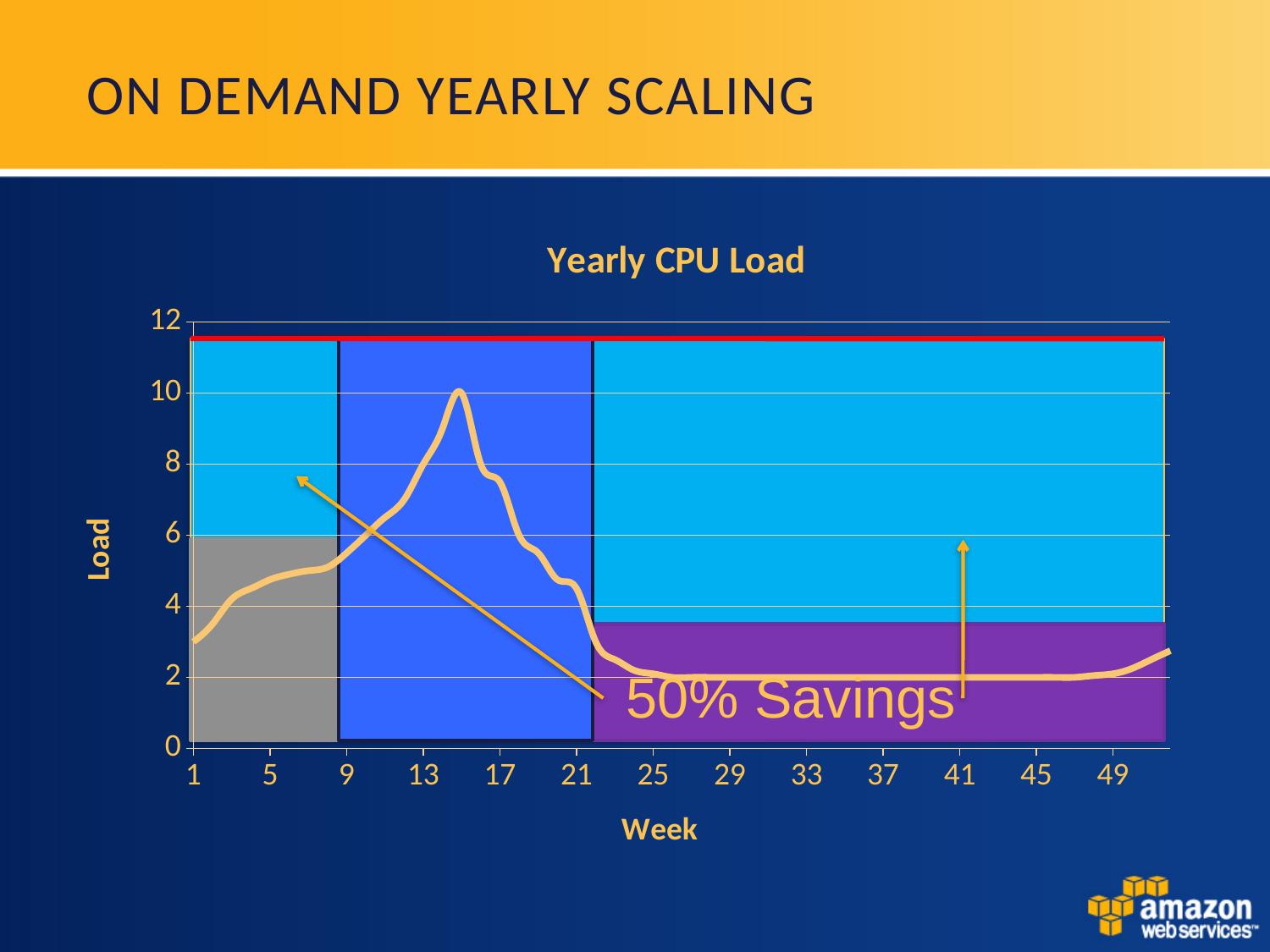
Is the CPU load at week 15 greater or less than 8? greater Is the CPU load at week 45 greater or less than 4? less What savings percentage is annotated on the chart? 50% Savings Is the CPU load at week 1 greater or less than 4? less Does the CPU load rise or fall between week 15 and week 25? fall Which is larger, the CPU load at week 15 or at week 33? week 15 What is the title of the chart? Yearly CPU Load What kind of chart is shown on the slide? line chart Does the CPU load rise or fall between week 9 and week 15? rise Between which two labelled weeks does the line reach its highest point? between weeks 13 and 17